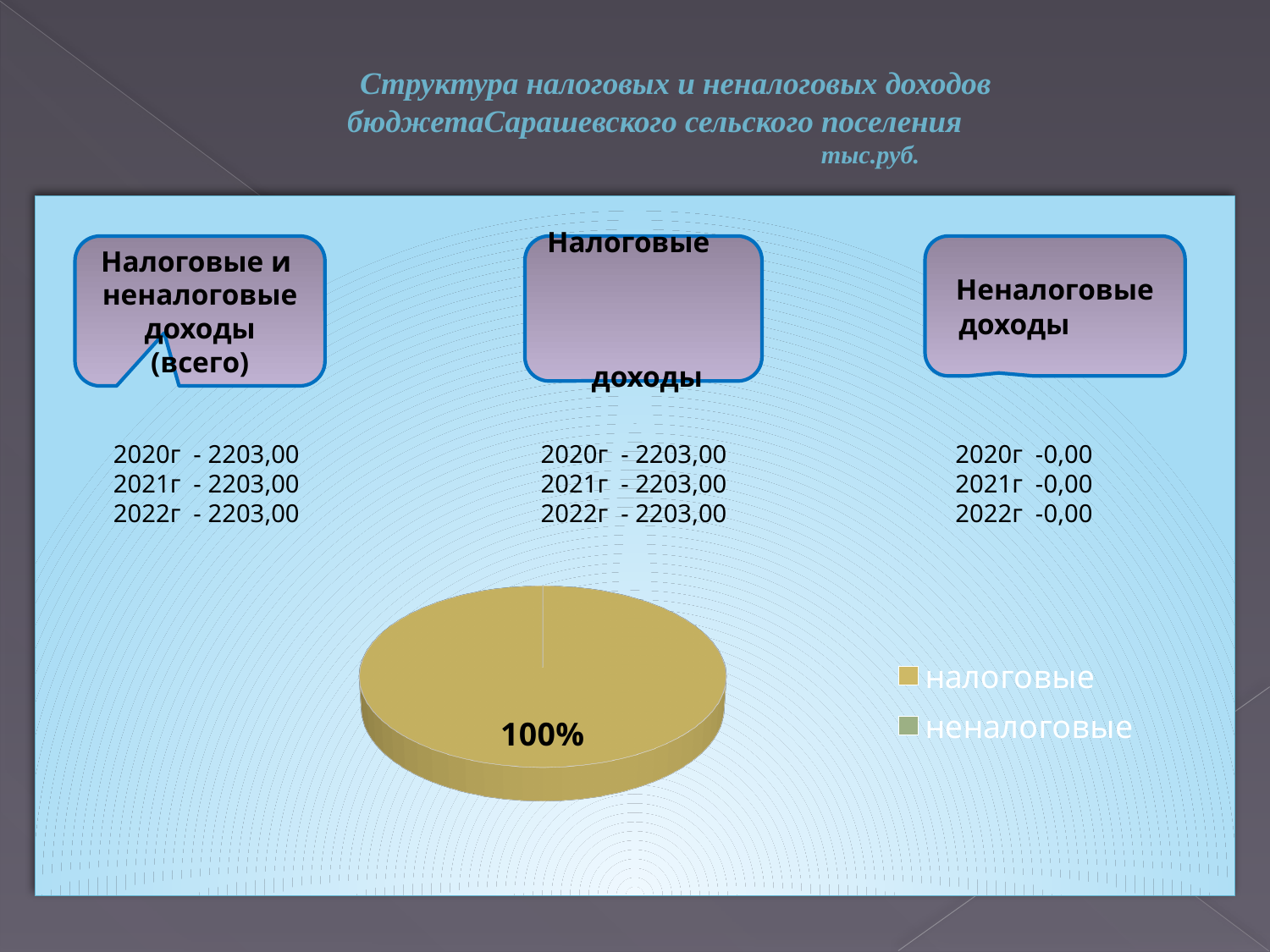
What are the two legend entries of the pie chart? налоговые, неналоговые How many slices are visible in the pie chart? 1 What share of the pie chart does the налоговые slice take? 100% Which category has the smallest share in the pie chart? неналоговые What kind of chart is shown on the slide? pie chart What colour is the налоговые slice in the pie chart? gold (yellow-brown) What data label is printed on the pie chart? 100% Which category has the largest slice in the pie chart? налоговые How many series does the legend of the pie chart list? 2 Which is larger in the pie chart, налоговые or неналоговые? налоговые